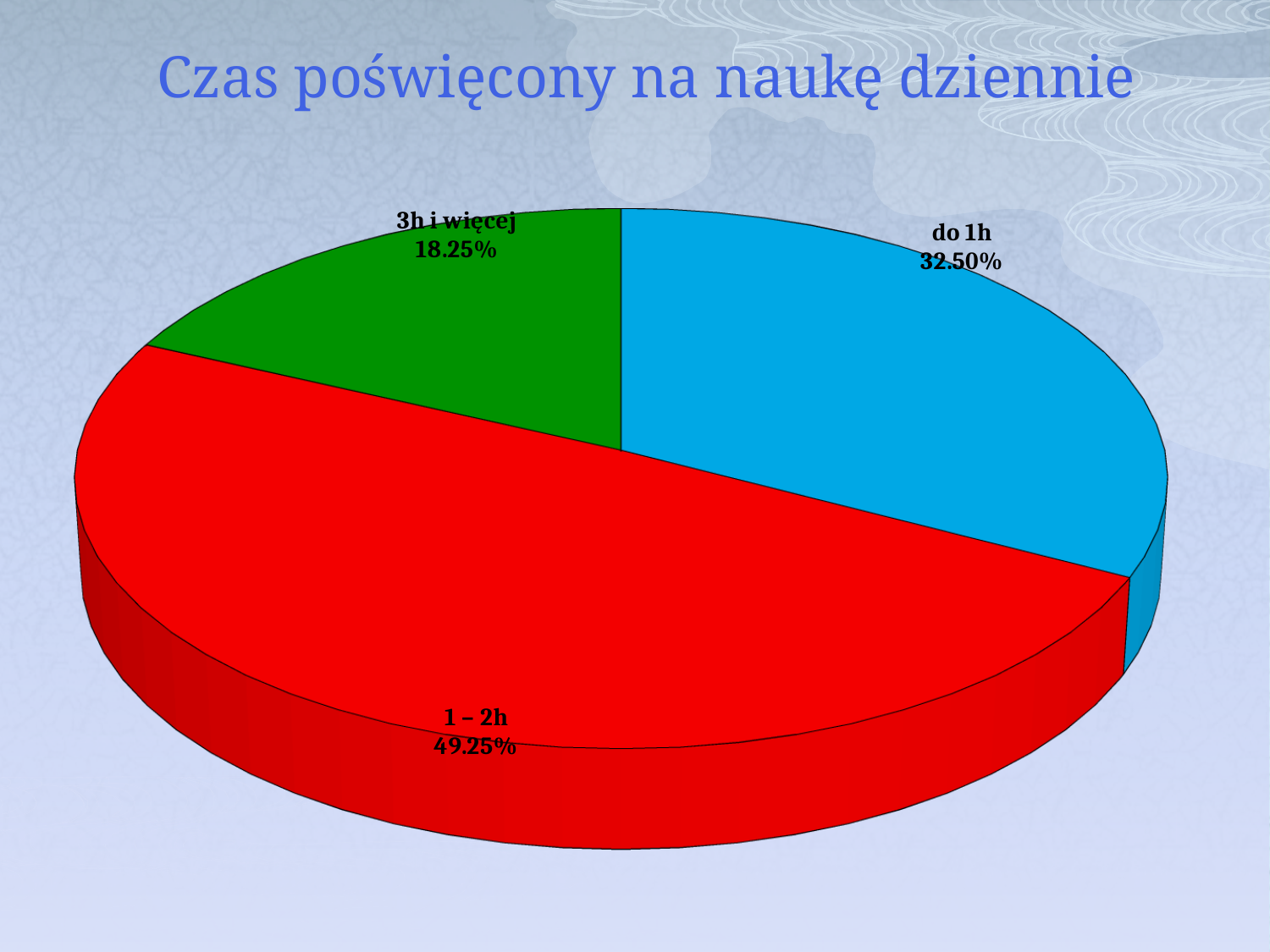
What kind of chart is shown on the slide? pie chart What share of the pie does the "1 – 2h" slice represent? 49.25% What colour is the "1 – 2h" slice? red How many categories are shown in the pie chart? 3 What is the difference between the "1 – 2h" share and the "do 1h" share? 16.75% What is the title of the chart? Czas poświęcony na naukę dziennie What is the difference between the "do 1h" share and the "3h i więcej" share? 14.25% What is the value shown for the "do 1h" slice? 32.50% Which category has the smallest slice of the pie? 3h i więcej Which category has the largest slice of the pie? 1 – 2h Which is larger: the "do 1h" slice or the "3h i więcej" slice? do 1h What is the value shown for the "3h i więcej" slice? 18.25%